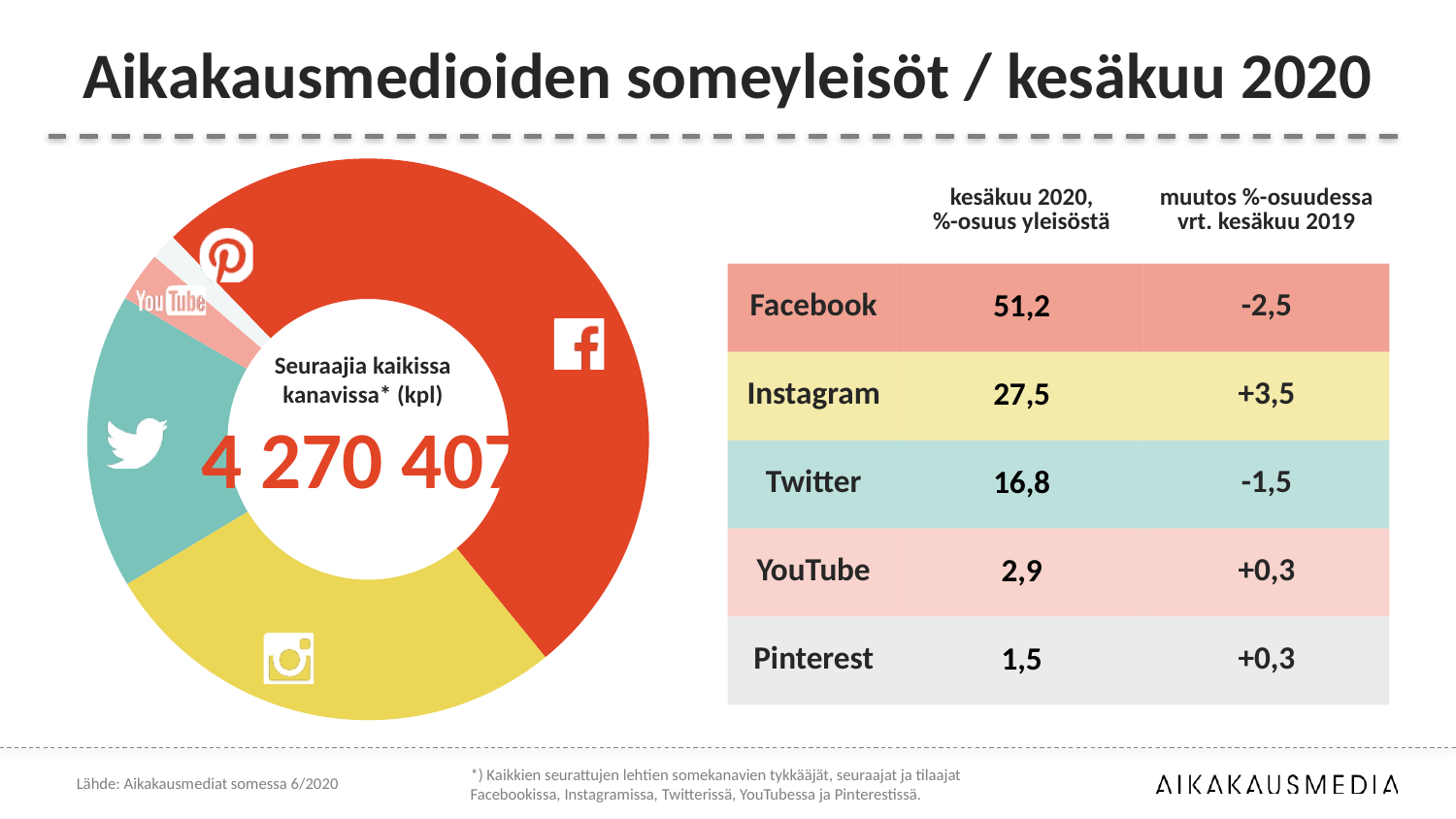
What is Instagram's %-share of the audience in June 2020? 27,5 Which has a larger share of the audience, Twitter or YouTube? Twitter What is the change in Twitter's %-share compared to June 2019? -1,5 What is the change in Pinterest's %-share compared to June 2019? +0,3 What is the title of the slide? Aikakausmedioiden someyleisöt / kesäkuu 2020 How much larger is Facebook's %-share than Instagram's in June 2020? 23,7 Which channel has the smallest share of the audience in the chart? Pinterest Which channel has the largest share of the audience in the chart? Facebook What is the total number of followers across all channels shown in the centre of the chart? 4 270 407 What is Facebook's %-share of the audience in June 2020? 51,2 How many social media channels are shown as slices in the chart? 5 What kind of chart is shown on the left of the slide? pie chart (donut)